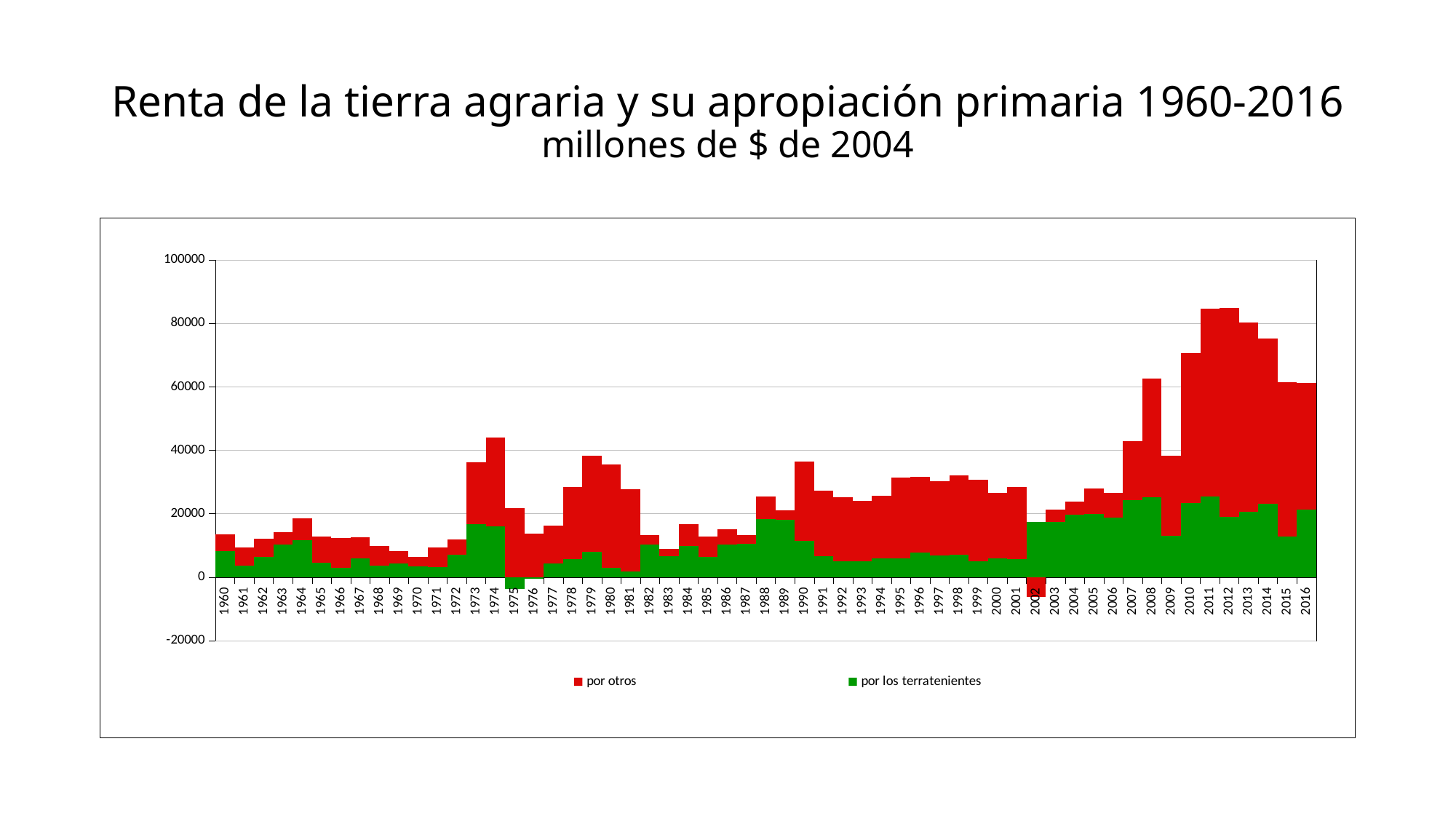
What are the two series named in the legend? por otros; por los terratenientes What kind of chart is shown on the slide? Stacked bar chart Is the value for 'por otros' in 2002 greater or less than 0? less Is the total stacked value for 1960 greater or less than 20000? less Which colour represents the series 'por los terratenientes'? Green Is the value for 'por los terratenientes' in 1975 greater or less than 0? less Which year has the larger total stacked value, 2008 or 2009? 2008 How many years are plotted along the x axis? 57 How many series does the legend list? 2